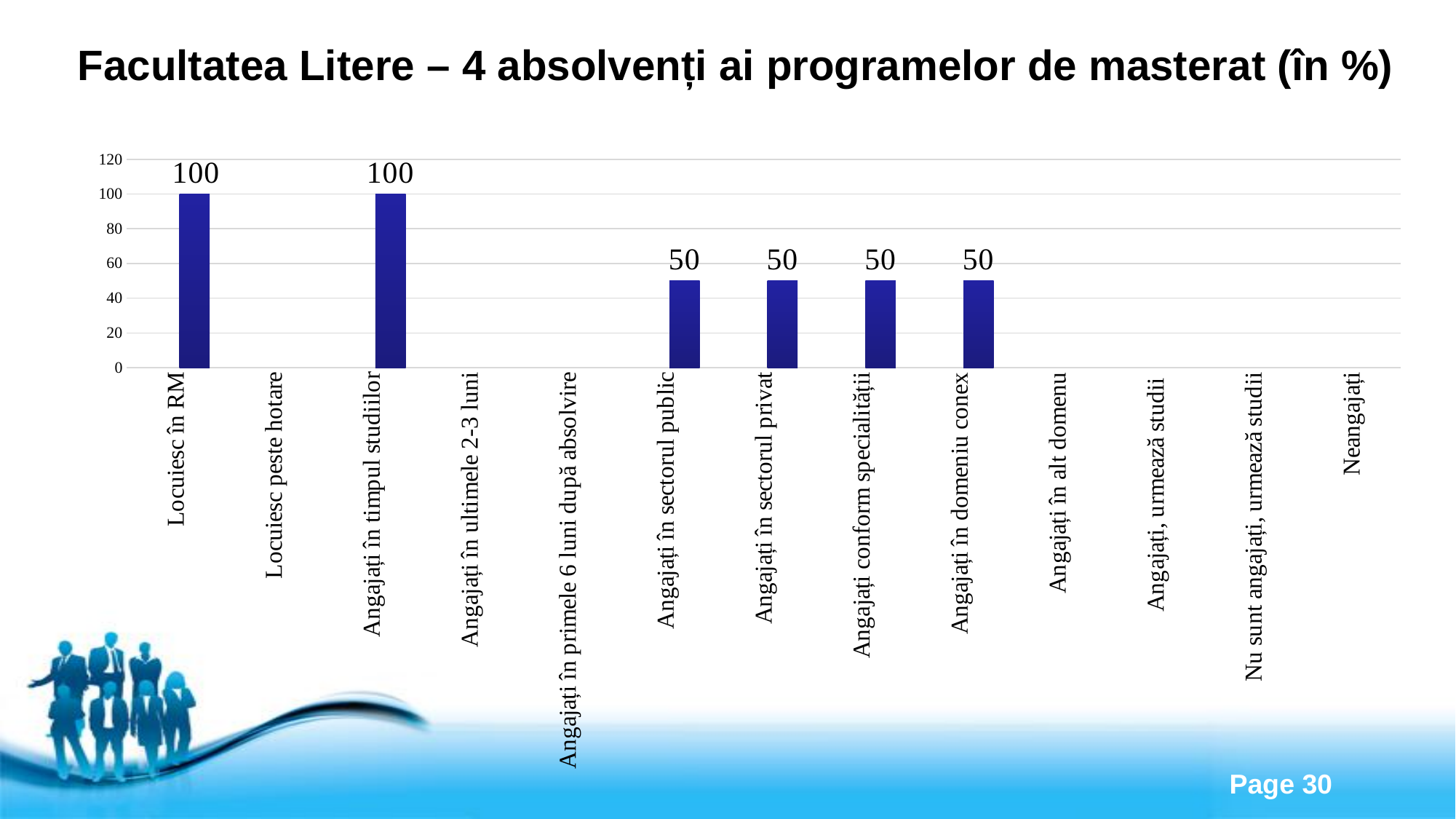
Is the value for "Locuiesc în RM" greater or less than 60? greater What is the title of the slide? Facultatea Litere – 4 absolvenți ai programelor de masterat (în %) How many categories are shown on the x axis of the chart? 13 Is the value for "Angajați în sectorul privat" greater or less than 80? less What kind of chart is shown on the slide? bar chart What is the value for "Angajați conform specialității"? 50 What is the value for "Angajați în timpul studiilor"? 100 Which is larger, the value for "Angajați în timpul studiilor" or the value for "Angajați în sectorul privat"? Angajați în timpul studiilor What is the difference between the values for "Locuiesc în RM" and "Angajați în domeniu conex"? 50 What is the value for "Locuiesc în RM"? 100 What is the value for "Angajați în sectorul public"? 50 What is the highest value shown on the vertical axis? 120